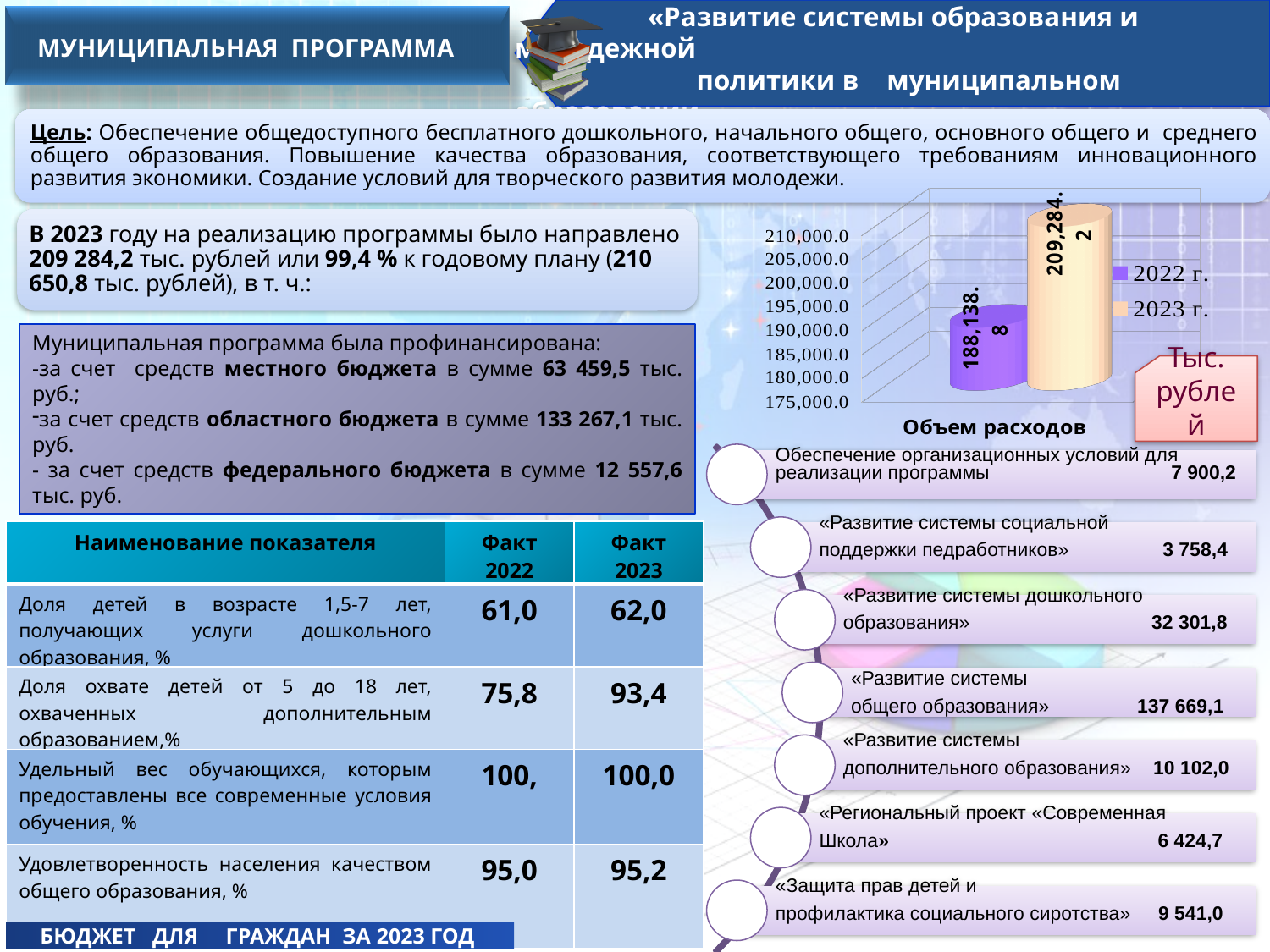
Which series has the lowest value in the chart? 2022 г. What kind of chart is shown on the slide? bar chart Which year has the higher value in the chart, 2022 г. or 2023 г.? 2023 г. Is the value for 2022 г. greater or less than 190,000.0? less How many series does the chart legend list? 2 Is the value for 2023 г. greater or less than 205,000.0? greater What is the value for 2022 г. in the chart? 188,138.8 What is the category label shown under the bars of the chart? Объем расходов What is the difference between the 2023 г. and 2022 г. values in the chart? 21,145.4 Which series has the highest value in the chart? 2023 г. What is the value for 2023 г. in the chart? 209,284.2 What unit is indicated next to the chart? Тыс. рублей